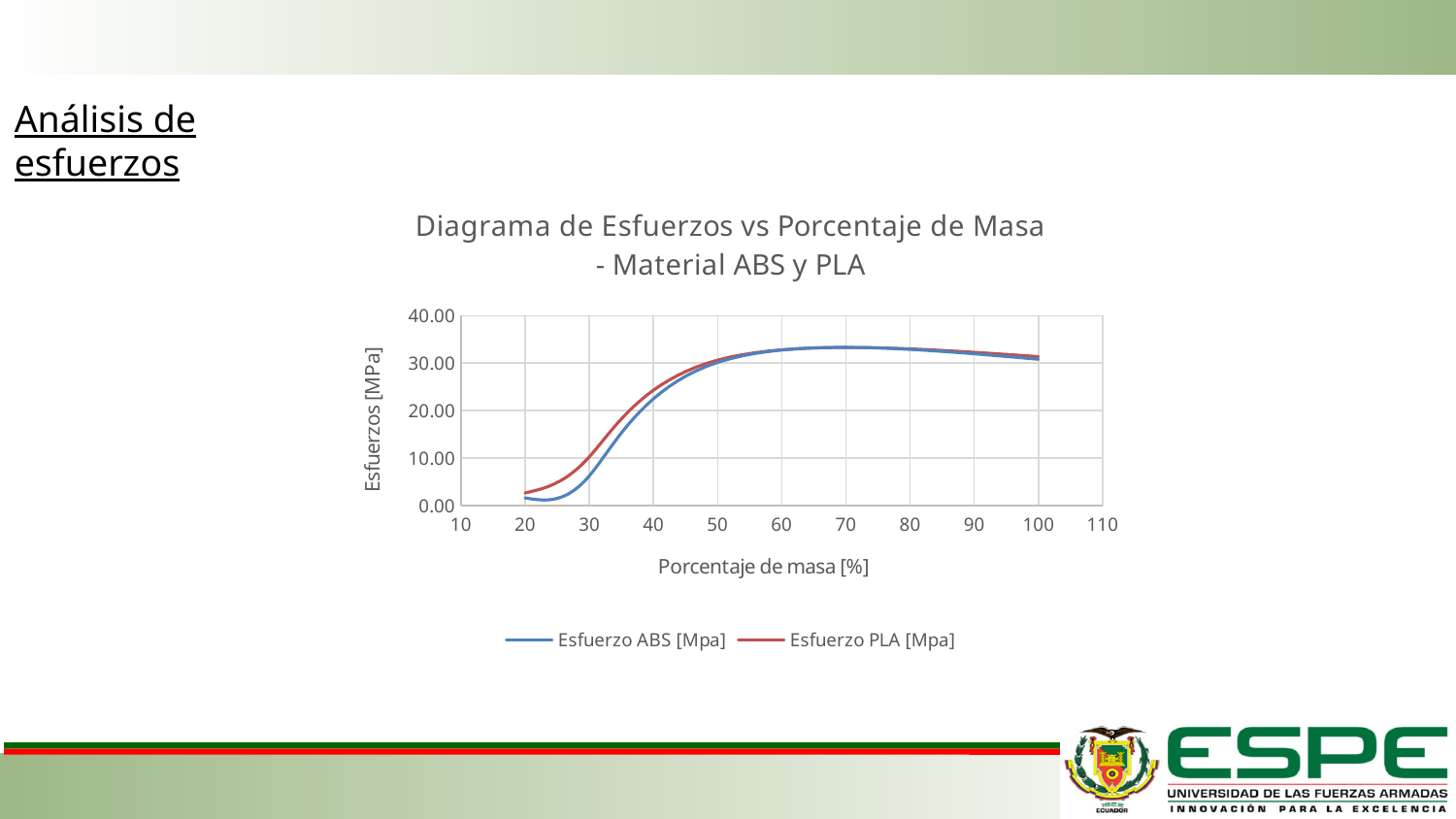
Between 20% and 50% mass, do the Esfuerzo ABS [Mpa] values rise or fall? rise What kind of chart is shown on the slide? Line chart What is the label of the x axis? Porcentaje de masa [%] Is the value of Esfuerzo ABS [Mpa] at 100% mass greater or less than 40.00? less Is the value of Esfuerzo ABS [Mpa] at 30% mass greater or less than 10.00? less Between 70% and 100% mass, do the Esfuerzo PLA [Mpa] values rise or fall? fall How many series does the legend list? 2 Is the value of Esfuerzo PLA [Mpa] at 20% mass greater or less than 10.00? less What is the title of the chart? Diagrama de Esfuerzos vs Porcentaje de Masa - Material ABS y PLA At 30% mass, which series has the larger value, Esfuerzo ABS [Mpa] or Esfuerzo PLA [Mpa]? Esfuerzo PLA [Mpa]